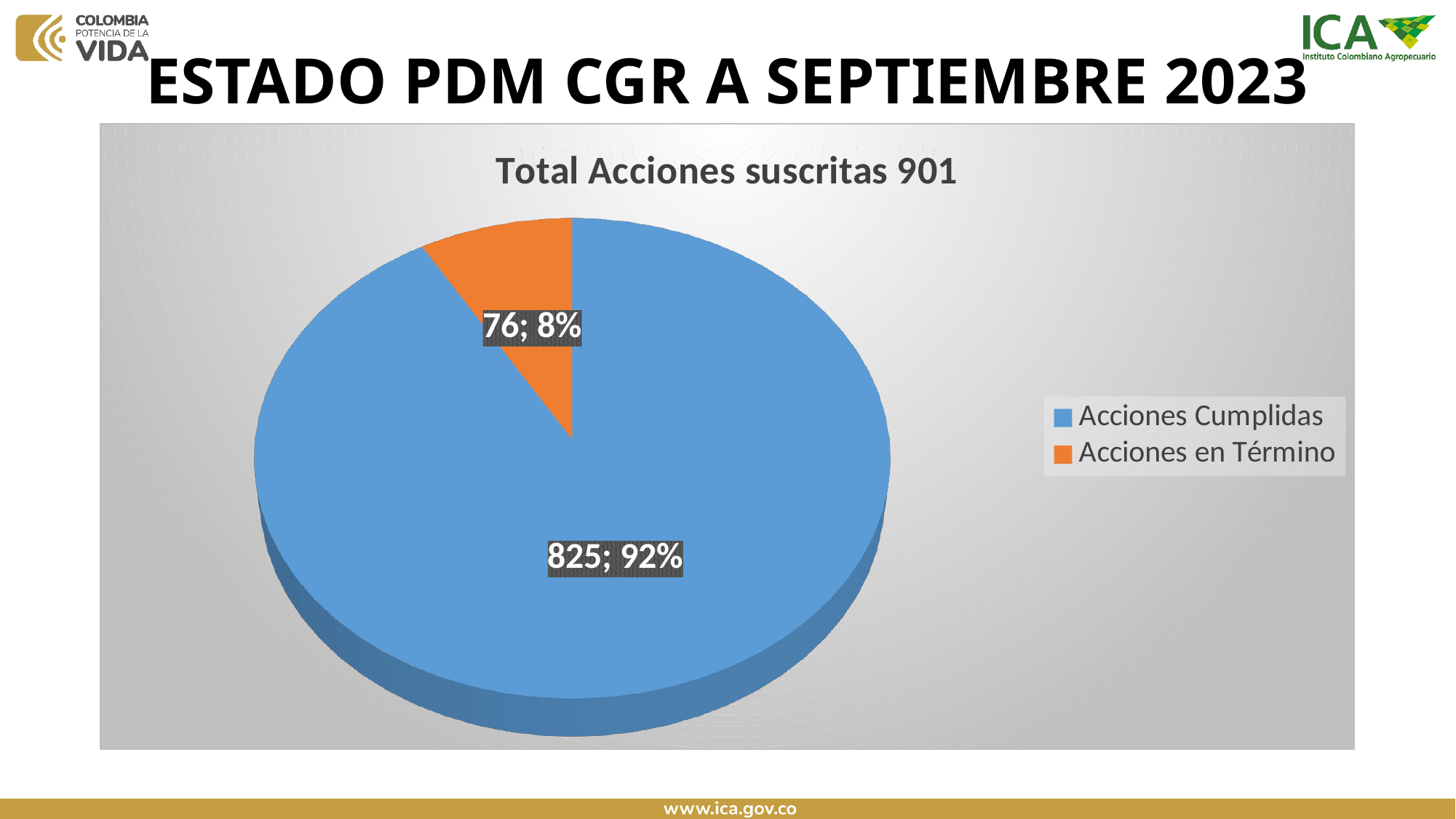
Which category has the smallest slice? Acciones en Término What is the value for Acciones en Término? 76 What kind of chart is shown on the slide? Pie chart What share of the pie does Acciones Cumplidas represent? 92% How many slices does the pie chart have? 2 What share of the pie does Acciones en Término represent? 8% What is the title of the chart? Total Acciones suscritas 901 What is the value for Acciones Cumplidas? 825 Which colour represents Acciones en Término in the chart? Orange Which category has the largest slice? Acciones Cumplidas How many entries does the legend list? 2 What is the difference between the values for Acciones Cumplidas and Acciones en Término? 749